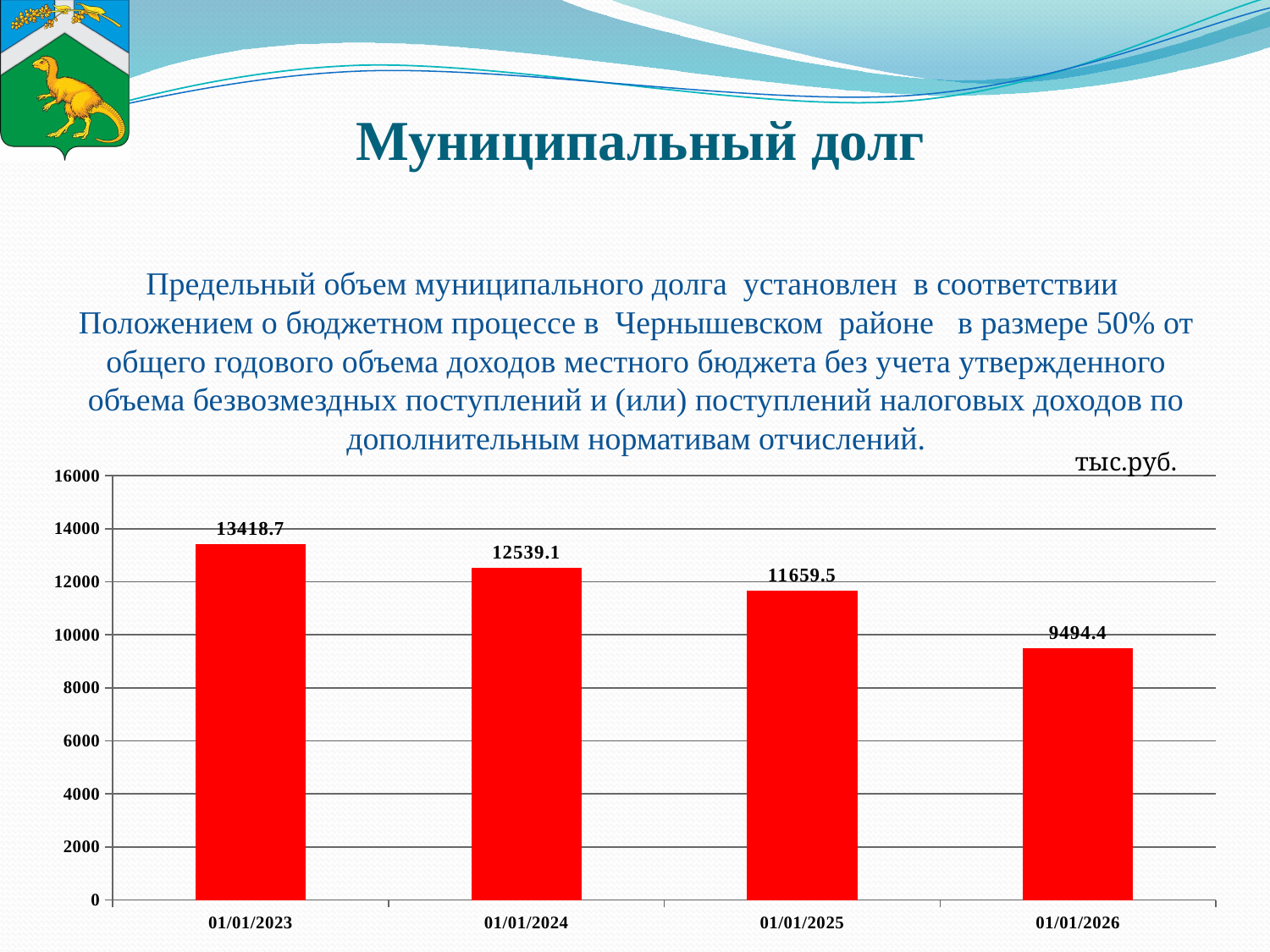
What is the value for 01/01/2026? 9494.4 Which date has the lowest value? 01/01/2026 What is the difference between the values for 01/01/2025 and 01/01/2026? 2165.1 What is the value for 01/01/2025? 11659.5 Which is larger, the value for 01/01/2024 or the value for 01/01/2025? 01/01/2024 What is the value for 01/01/2024? 12539.1 What is the difference between the values for 01/01/2023 and 01/01/2024? 879.6 Which date has the highest value? 01/01/2023 How many bars are shown in the chart? 4 What is the value for 01/01/2023? 13418.7 Do the values rise or fall from 01/01/2023 to 01/01/2026? fall Is the value for 01/01/2026 greater or less than 10000? less